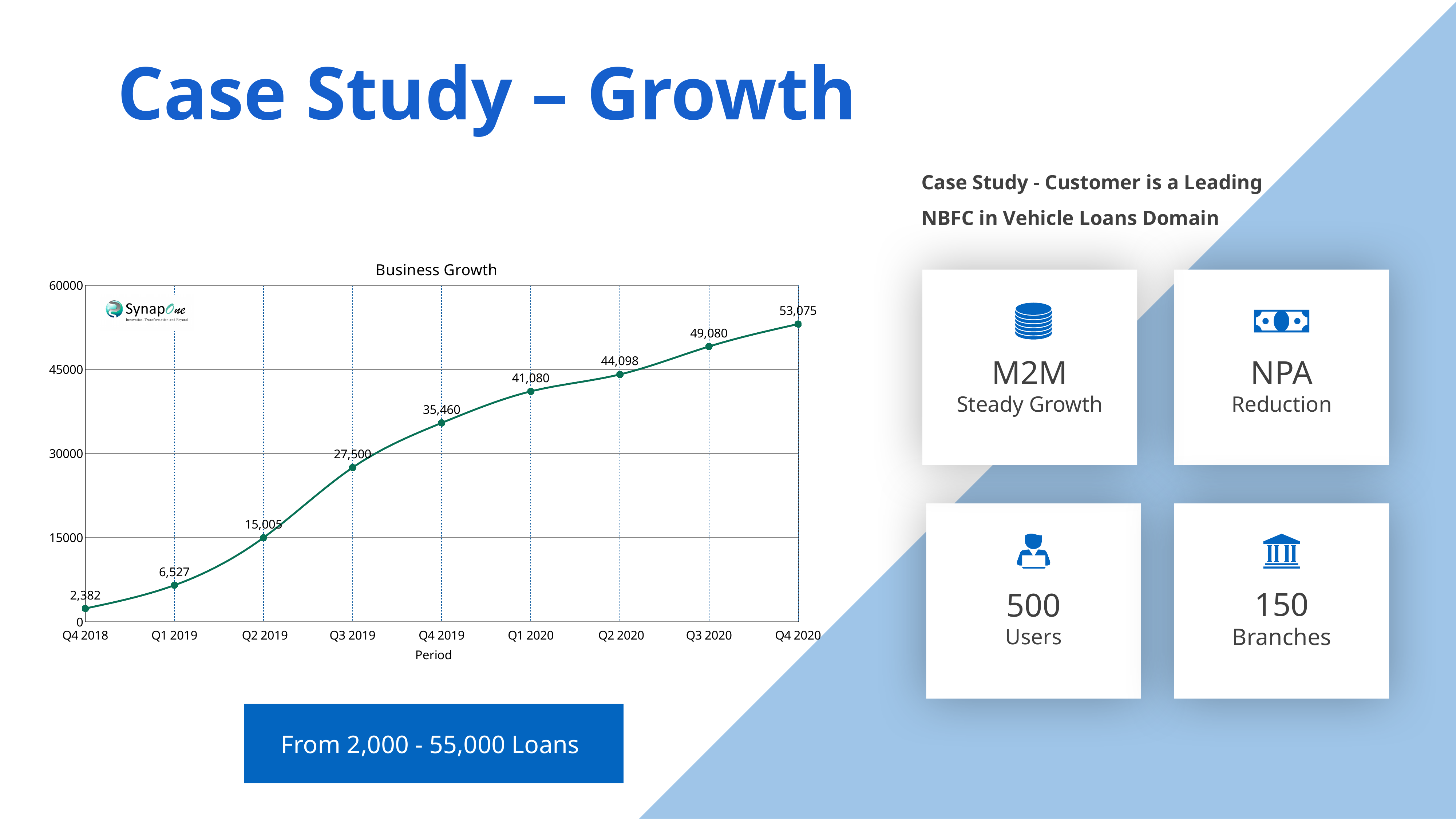
What kind of chart is the Business Growth chart? line chart Which period has the highest value in the Business Growth chart? Q4 2020 How many periods are plotted in the Business Growth chart? 9 What is the value for Q2 2020 in the Business Growth chart? 44,098 Which period has the lowest value in the Business Growth chart? Q4 2018 What is the value for Q3 2019 in the Business Growth chart? 27,500 Is the value for Q3 2020 in the Business Growth chart greater or less than 45000? greater What is the value for Q4 2018 in the Business Growth chart? 2,382 What is the difference between the values for Q2 2019 and Q1 2019 in the Business Growth chart? 8,478 What is the difference between the values for Q4 2020 and Q3 2020 in the Business Growth chart? 3,995 Do the values in the Business Growth chart rise or fall from Q4 2018 to Q4 2020? rise Which is larger in the Business Growth chart, the value for Q4 2019 or the value for Q1 2020? Q1 2020